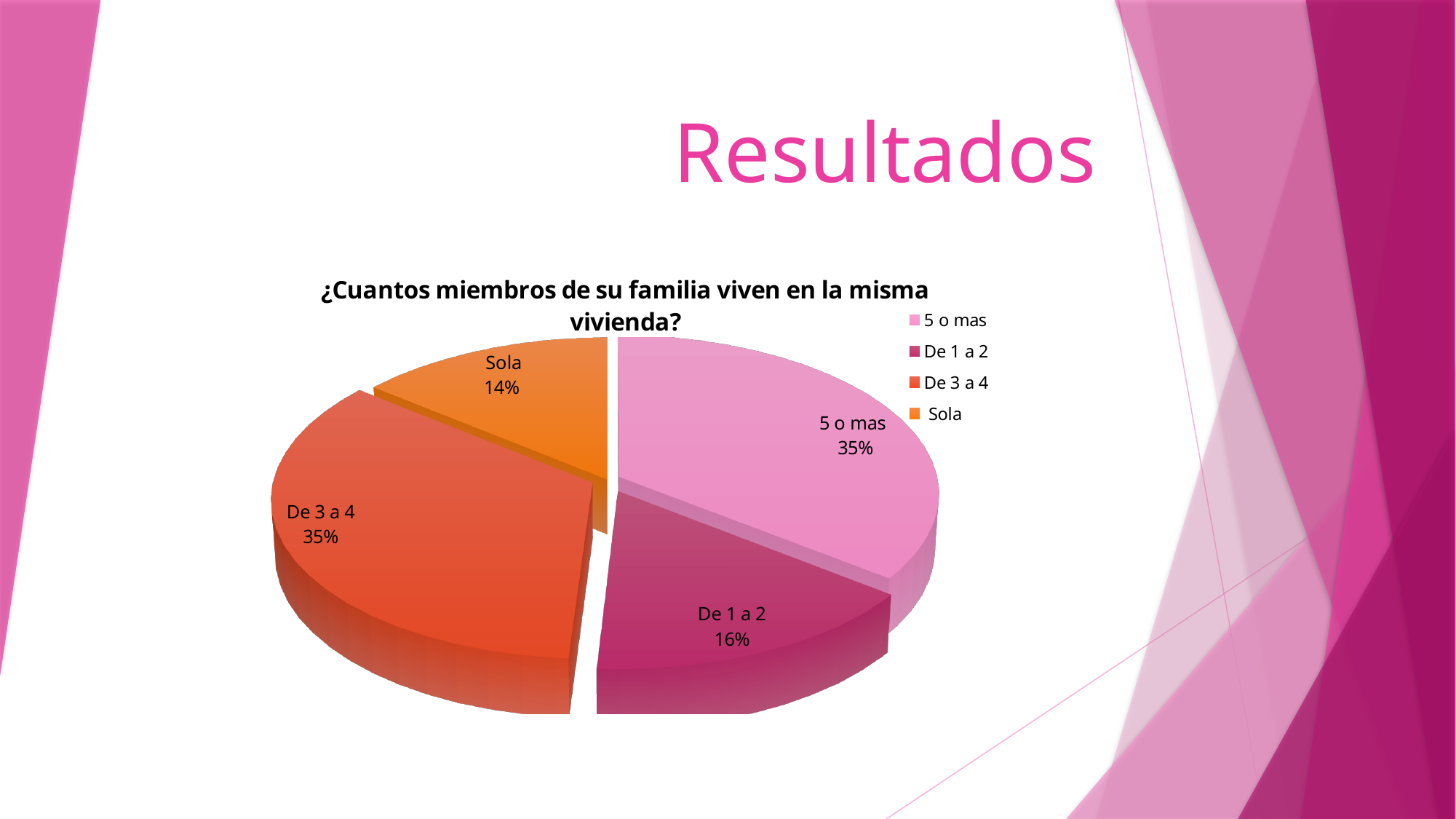
What percentage of the pie is the 'De 1 a 2' slice? 16% What percentage of the pie is the 'De 3 a 4' slice? 35% How many slices does the pie chart have? 4 What percentage of the pie is the 'Sola' slice? 14% What kind of chart is shown on the slide? pie chart What percentage of the pie is the '5 o mas' slice? 35% Which slice is larger, 'De 1 a 2' or 'Sola'? De 1 a 2 What is the title of the chart? ¿Cuantos miembros de su familia viven en la misma vivienda? How many entries does the legend list? 4 What colour is the 'Sola' slice in the pie chart? orange Which category has the smallest slice of the pie? Sola What is the difference in percentage points between the '5 o mas' slice and the 'De 1 a 2' slice? 19%